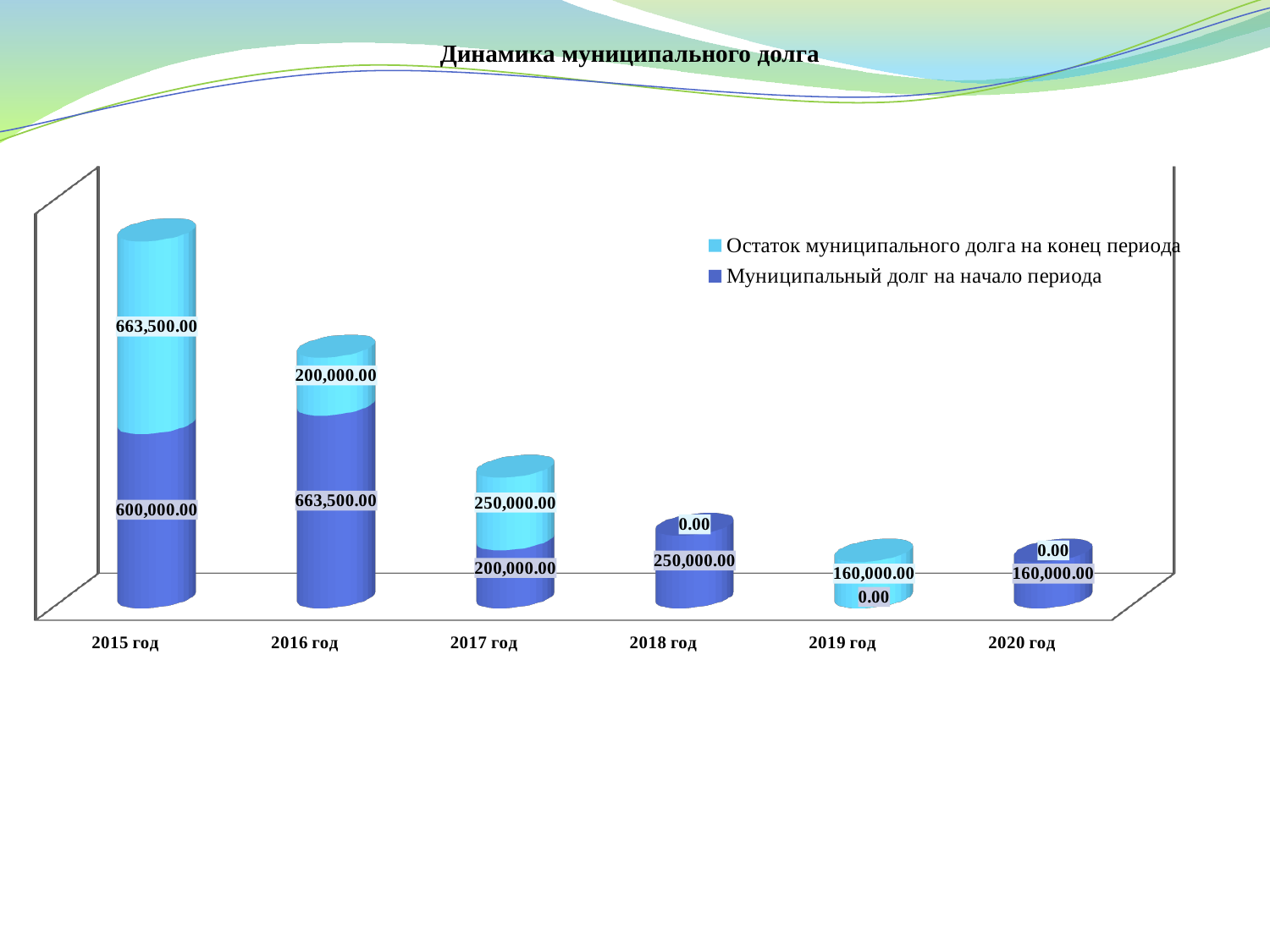
What is the value of 'Остаток муниципального долга на конец периода' for 2015 год? 663,500.00 What is the title of the chart? Динамика муниципального долга What is the value of 'Муниципальный долг на начало периода' for 2020 год? 160,000.00 What is the value of 'Остаток муниципального долга на конец периода' for 2018 год? 0.00 What type of chart is shown on the slide? bar chart Which year has the tallest stacked bar? 2015 год What is the total of the stacked bar for 2016 год? 863,500.00 How many year categories are shown on the x axis? 6 How many series does the legend list? 2 What is the value of 'Муниципальный долг на начало периода' for 2017 год? 200,000.00 What is the value of 'Муниципальный долг на начало периода' for 2015 год? 600,000.00 What is the difference between 'Остаток муниципального долга на конец периода' and 'Муниципальный долг на начало периода' for 2017 год? 50,000.00